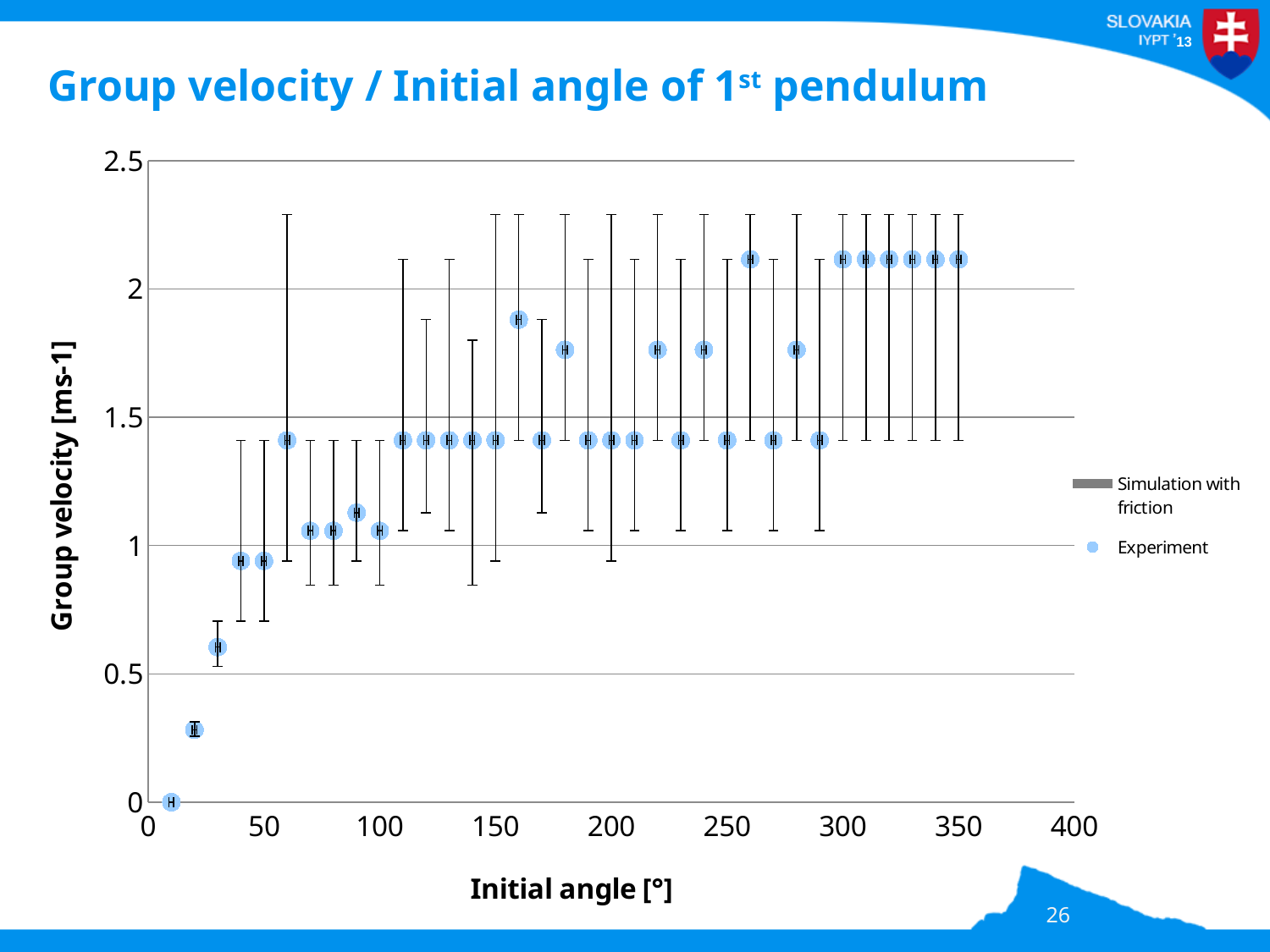
How many series does the legend list? 2 Is the group velocity at an initial angle of 20° greater or less than 0.5? less Is the group velocity at an initial angle of 110° greater or less than 1.5? less Which initial angle has the lowest group velocity? 10° Is the group velocity at an initial angle of 30° greater or less than 0.5? greater What kind of chart is shown on the slide? Scatter chart What is the title of the chart? Group velocity / Initial angle of 1st pendulum What is the label of the y axis? Group velocity [ms-1] Do the group velocity values generally rise or fall as the initial angle increases? rise